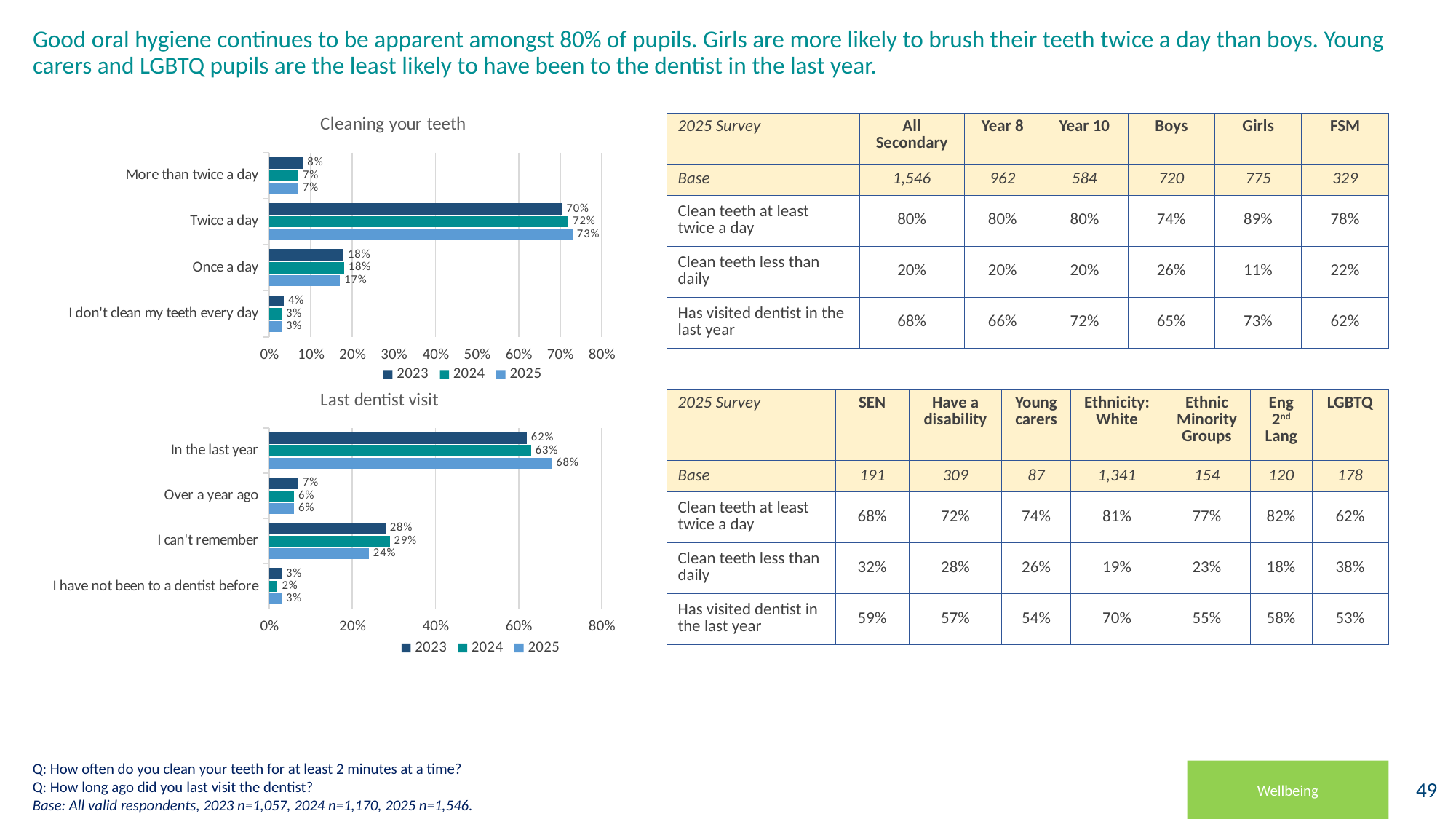
In the 'Last dentist visit' chart, what is the 2025 value for 'In the last year'? 68% In the 'Cleaning your teeth' chart, what is the difference between the 2025 and 2023 values for 'Twice a day'? 3 percentage points In the 'Last dentist visit' chart, which is larger for 2025: 'Over a year ago' or 'I can't remember'? I can't remember In the 'Cleaning your teeth' chart, what is the 2023 value for 'Once a day'? 18% In the 'Last dentist visit' chart, how many categories are shown on the y axis? 4 In the 'Cleaning your teeth' chart, how many series does the legend list? 3 In the 'Cleaning your teeth' chart, what is the 2025 value for 'Twice a day'? 73% What type of chart is the 'Last dentist visit' chart? Bar chart In the 'Last dentist visit' chart, is the 2025 value for 'In the last year' greater or less than 60%? greater In the 'Cleaning your teeth' chart, which category has the lowest value in 2023? I don't clean my teeth every day In the 'Last dentist visit' chart, what is the 2024 value for 'I can't remember'? 29% In the 'Cleaning your teeth' chart, which category has the highest value in 2024? Twice a day